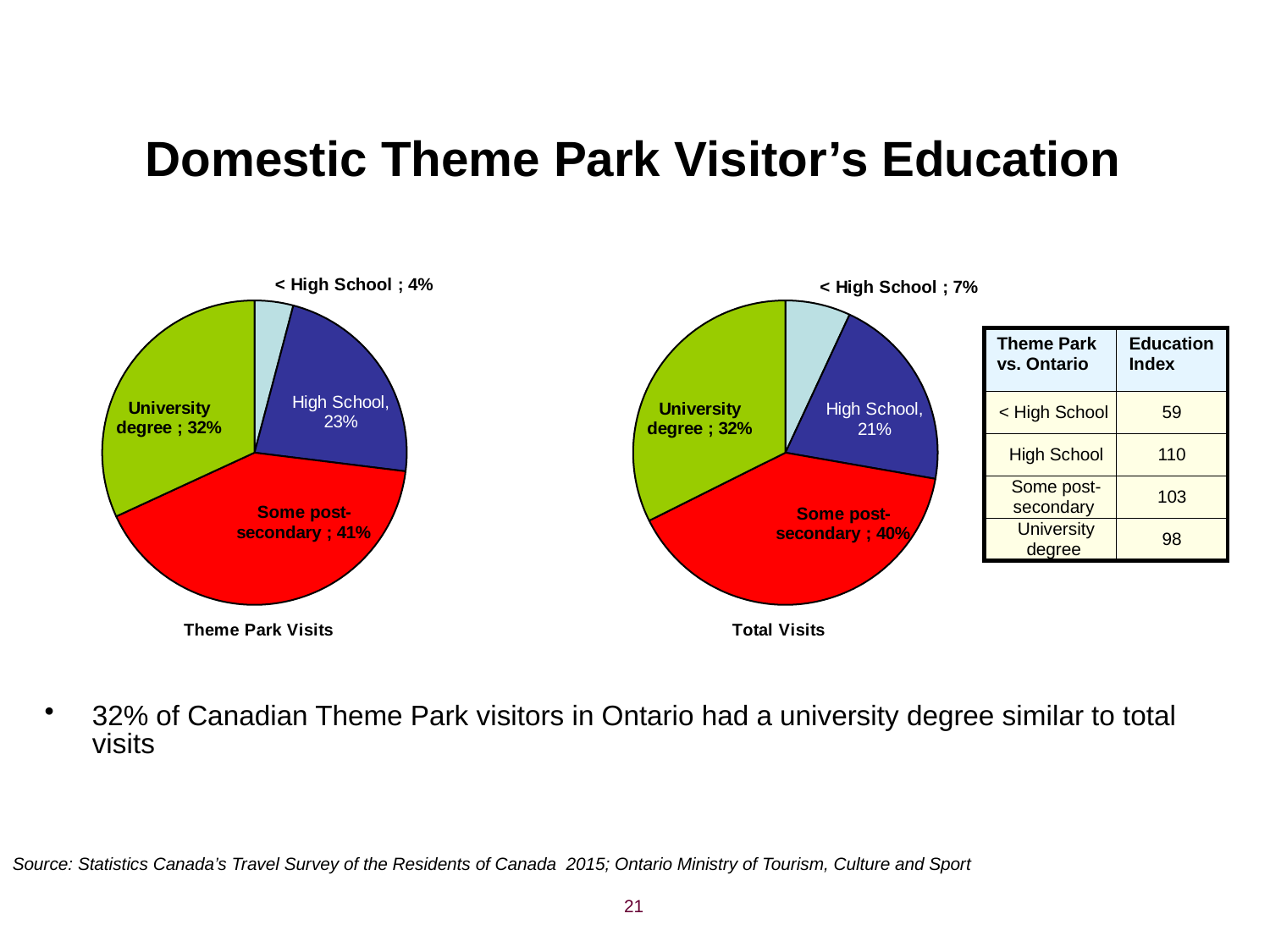
In the Theme Park Visits pie chart, what colour is the Some post-secondary slice? Red In the Theme Park Visits pie chart, what share of visitors had some post-secondary education? 41% In the Total Visits pie chart, what share of visitors had less than high school education? 7% In the Theme Park Visits pie chart, what share of visitors had a high school education? 23% What is the title of the pie chart on the right side of the slide? Total Visits What type of chart is used to show Theme Park Visits by education? Pie chart In the Total Visits pie chart, what share of visitors had a university degree? 32% How many education categories are shown in the Theme Park Visits pie chart? 4 In the Total Visits pie chart, which education category has the smallest share? < High School In the Theme Park Visits pie chart, which education category has the largest share? Some post-secondary What is the difference between the High School share in the Theme Park Visits chart and the High School share in the Total Visits chart? 2 percentage points Which is larger: the < High School share in the Theme Park Visits chart or in the Total Visits chart? Total Visits